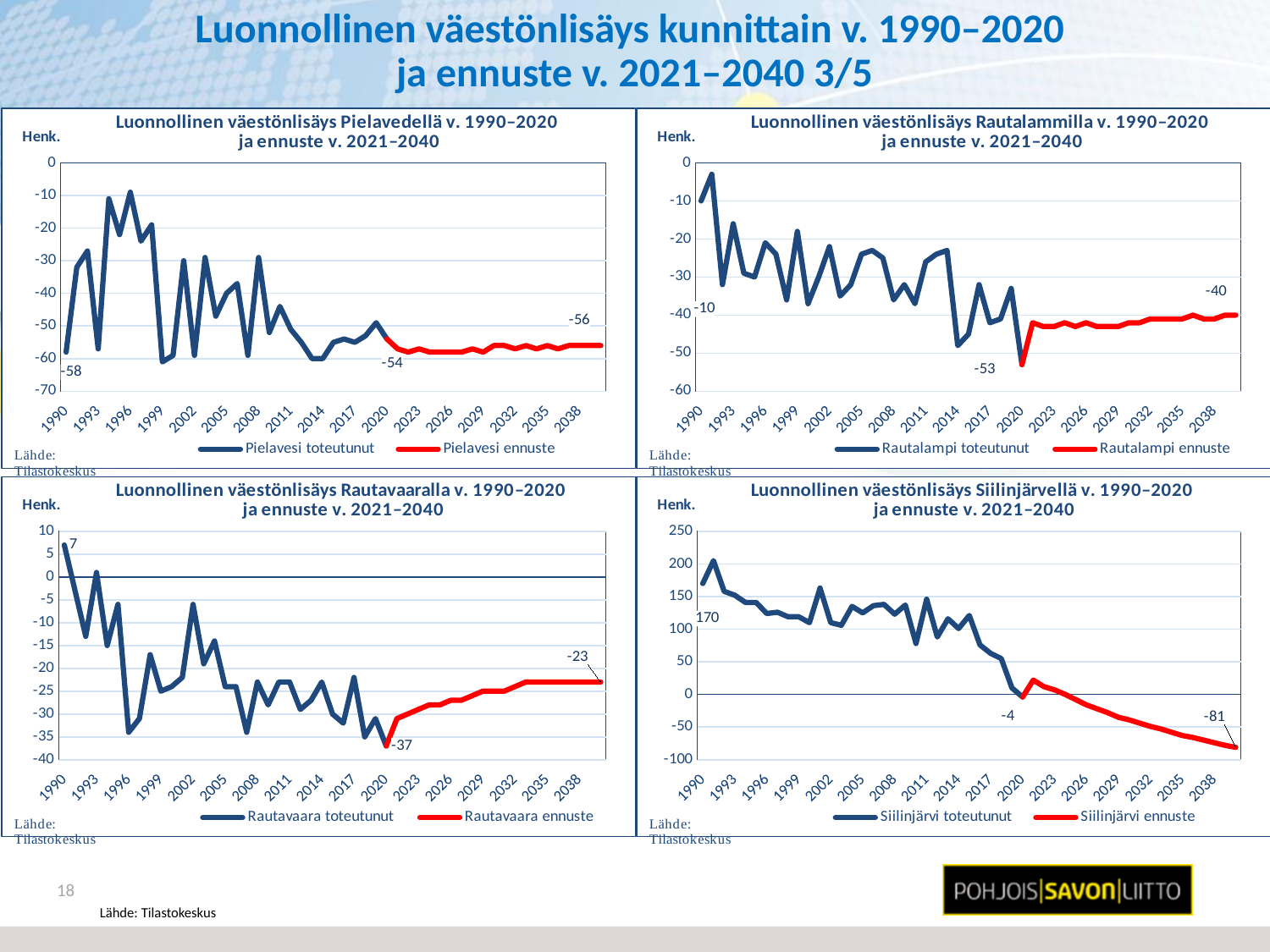
In the Pielavesi chart (top left), what is the labelled value for 1990? -58 In the Siilinjärvi chart (bottom right), what is the labelled value for 1990? 170 How many series does the legend of the Pielavesi chart (top left) list? 2 In the Rautavaara chart (bottom left), which is larger: the 2020 value or the 2040 forecast value? 2040 forecast value (-23) In the Rautavaara chart (bottom left), what is the labelled value for 1990? 7 In the Rautalampi chart (top right), what is the labelled value for 2020? -53 In the Pielavesi chart (top left), what is the labelled forecast value for 2040? -56 In the Siilinjärvi chart (bottom right), what is the labelled forecast value for 2040? -81 What kind of chart is the Rautalampi chart (top right)? line chart In the Siilinjärvi chart (bottom right), does the forecast line rise or fall from 2021 to 2040? fall In the Rautalampi chart (top right), what is the difference between the 2040 forecast value (-40) and the 2020 value (-53)? 13